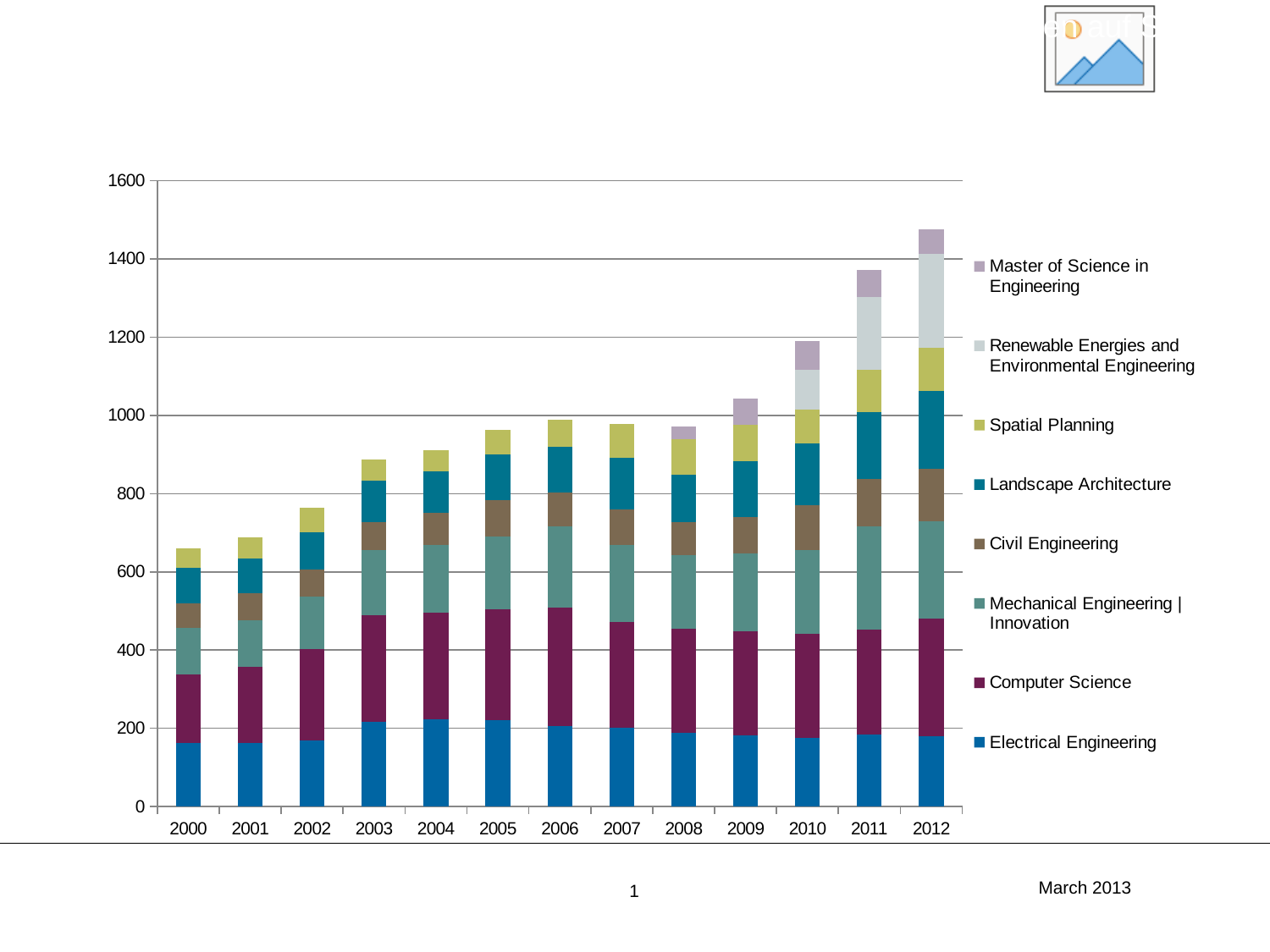
How many years are shown along the x axis of the chart? 13 Which series is shown at the bottom of each stacked bar? Electrical Engineering Which year has the larger total stacked bar, 2003 or 2005? 2005 Is the total stacked value for 2011 greater or less than 1400? less Is the total stacked value for 2009 greater or less than 1000? greater Which year has the tallest stacked bar? 2012 Is the total stacked value for 2012 greater or less than 1400? greater Do the total stacked values generally rise or fall from 2000 to 2012? rise What kind of chart is shown on the slide? stacked bar chart How many series does the chart's legend list? 8